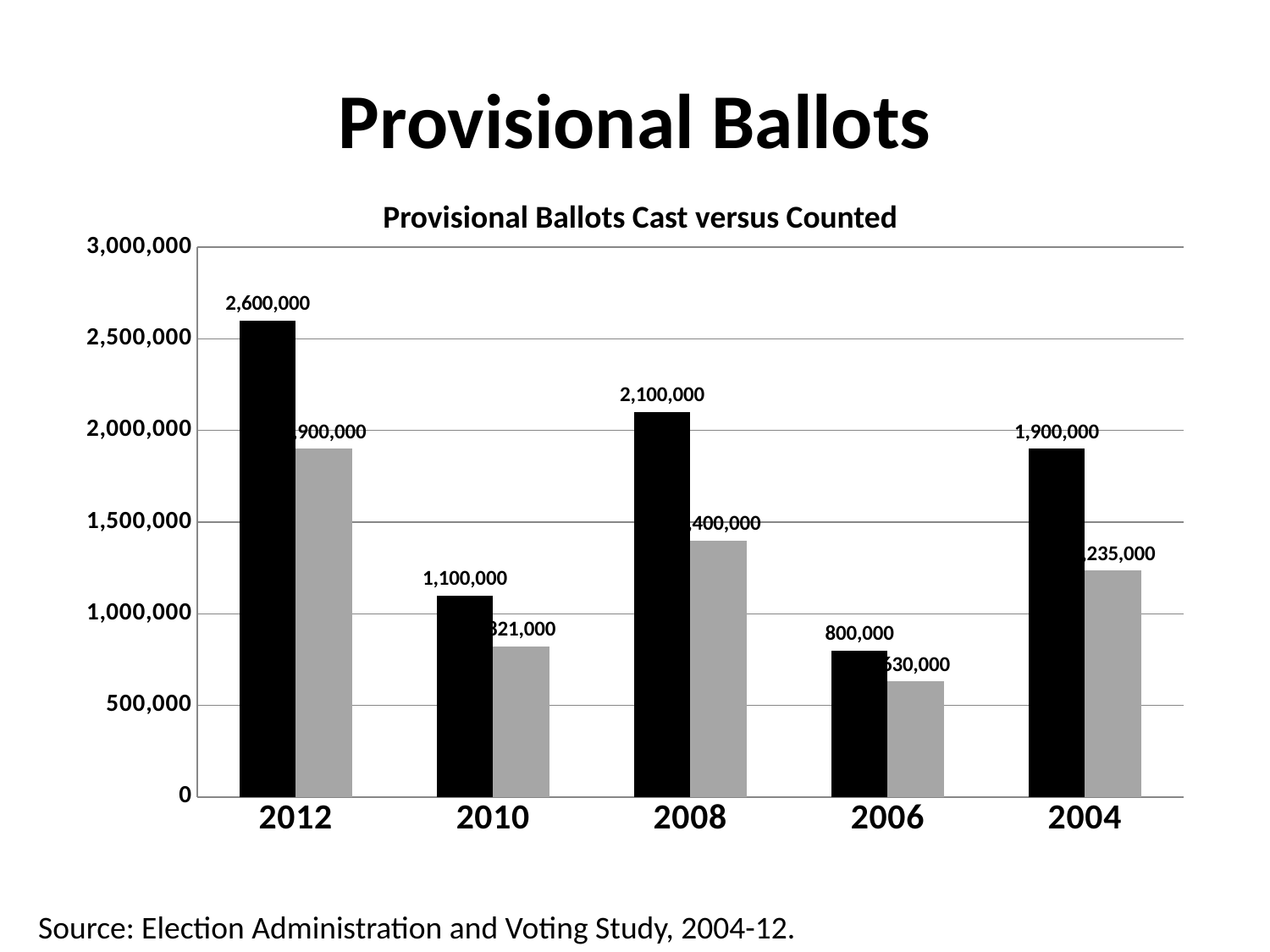
What is the difference between the black bar values for 2004 and 2010? 800,000 Which year has the lowest black bar? 2006 Is the value of the gray bar for 2012 greater or less than 1,500,000? greater Which has a larger black bar value, 2004 or 2010? 2004 What is the value of the black bar for 2006? 800,000 Which year has the highest black bar? 2012 Is the value of the gray bar for 2006 greater or less than 1,000,000? less What is the value of the black bar for 2012? 2,600,000 What is the difference between the black bar values for 2012 and 2008? 500,000 How many years are shown on the x axis? 5 What is the value of the black bar for 2008? 2,100,000 What is the value of the black bar for 2010? 1,100,000